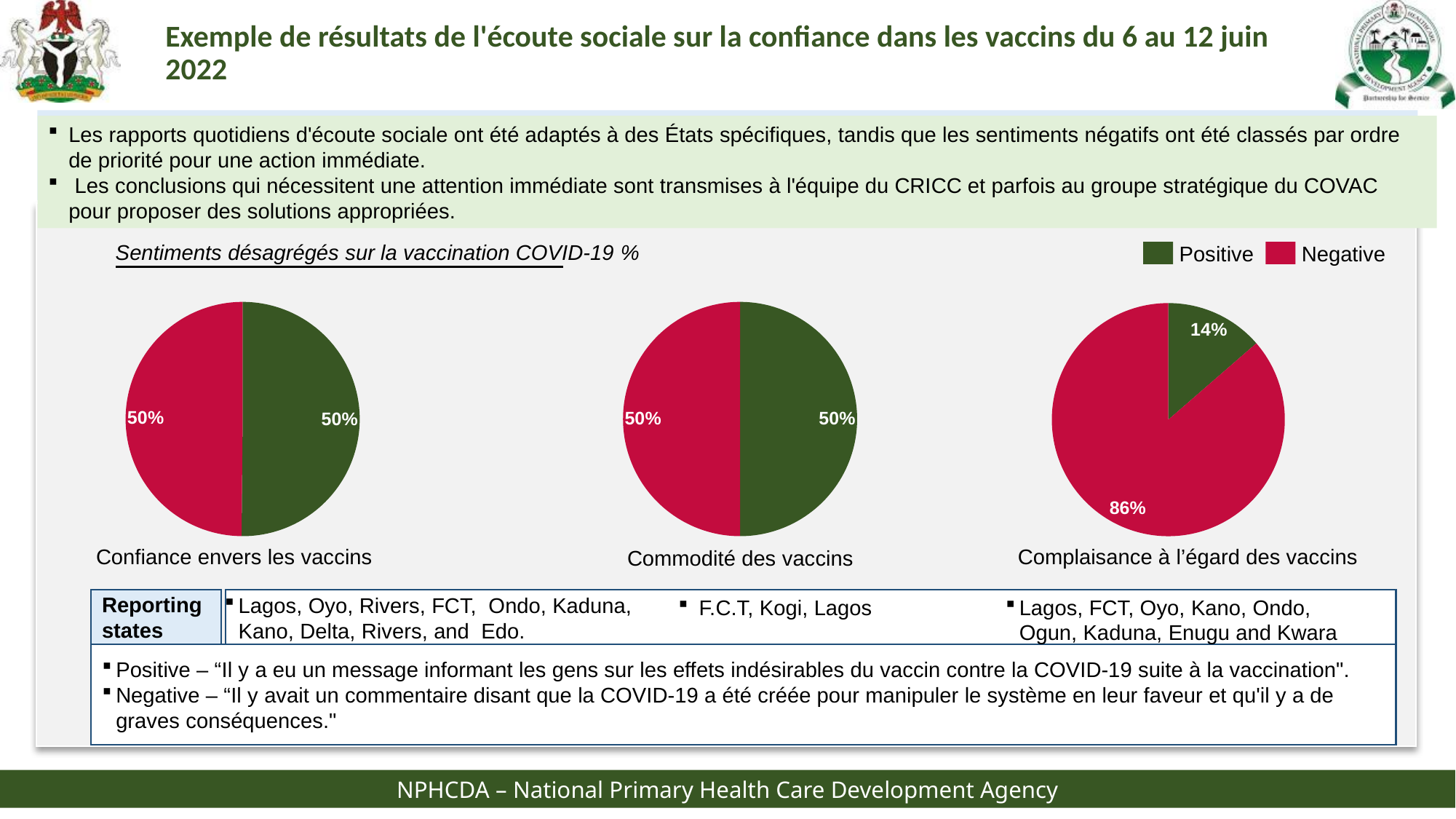
In the 'Commodité des vaccins' pie chart, what is the Negative share? 50% Which colour represents Negative sentiment in the pie charts? Red In the 'Confiance envers les vaccins' pie chart, what is the Positive share? 50% In the 'Complaisance à l’égard des vaccins' pie chart, which sentiment has the largest share? Negative How many slices does the 'Confiance envers les vaccins' pie chart have? 2 What kind of chart is used for 'Complaisance à l’égard des vaccins'? Pie chart In the 'Complaisance à l’égard des vaccins' pie chart, what is the Negative share? 86% In the 'Complaisance à l’égard des vaccins' pie chart, is the Positive share larger or smaller than the Negative share? Smaller In the 'Complaisance à l’égard des vaccins' pie chart, what is the difference between the Negative and Positive shares? 72% In the 'Complaisance à l’égard des vaccins' pie chart, what is the Positive share? 14% How many entries does the shared legend list for the pie charts? 2 In the 'Complaisance à l’égard des vaccins' pie chart, which sentiment has the smallest share? Positive